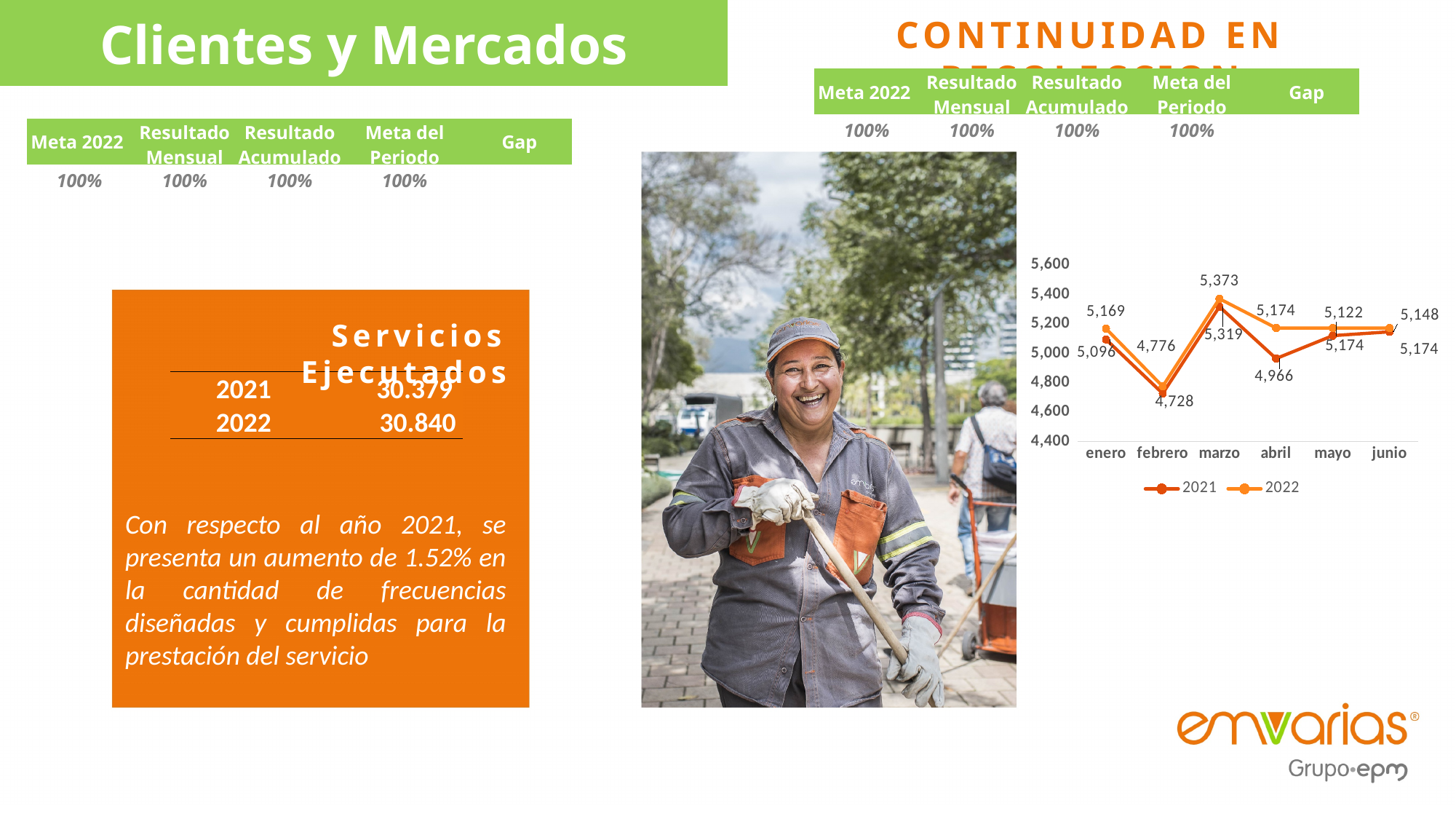
In the line chart, what is the value for 2022 in marzo? 5,373 In the line chart, is the 2021 value for febrero greater or less than 4,800? less In the line chart, what is the value for 2022 in enero? 5,169 In the line chart, which month has the highest value for the 2022 series? marzo In the line chart, what is the difference between the 2022 and 2021 values in abril? 208 In the line chart, what is the value for 2021 in abril? 4,966 In the line chart, which month has the lowest value for the 2021 series? febrero In the line chart, what is the value for 2021 in febrero? 4,728 In the line chart, which series has the larger value in abril, 2021 or 2022? 2022 How many months are plotted along the x axis of the line chart? 6 What kind of chart is shown on the right side of the slide? line chart How many series does the legend of the line chart list? 2